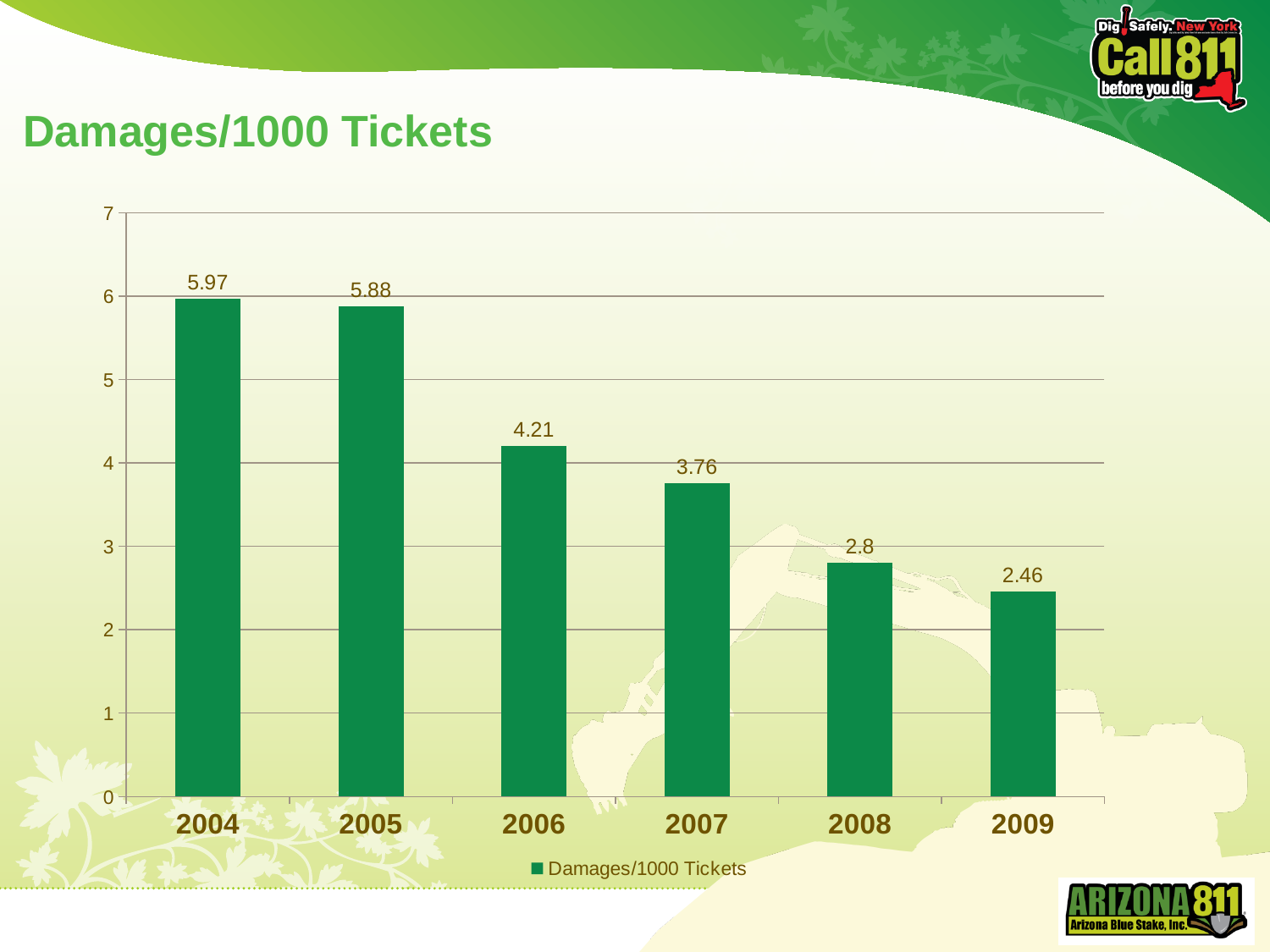
What is the difference between the values for 2004 and 2009? 3.51 How many years are shown on the x axis? 6 What is the value for 2009? 2.46 What is the value for 2007? 3.76 What is the difference between the values for 2006 and 2007? 0.45 Which is larger, the value for 2006 or the value for 2008? 2006 Which year has the highest value? 2004 Which year has the lowest value? 2009 How many series does the legend list? 1 What kind of chart is shown? bar chart Do the values rise or fall from 2004 to 2009? fall What is the value for 2004? 5.97